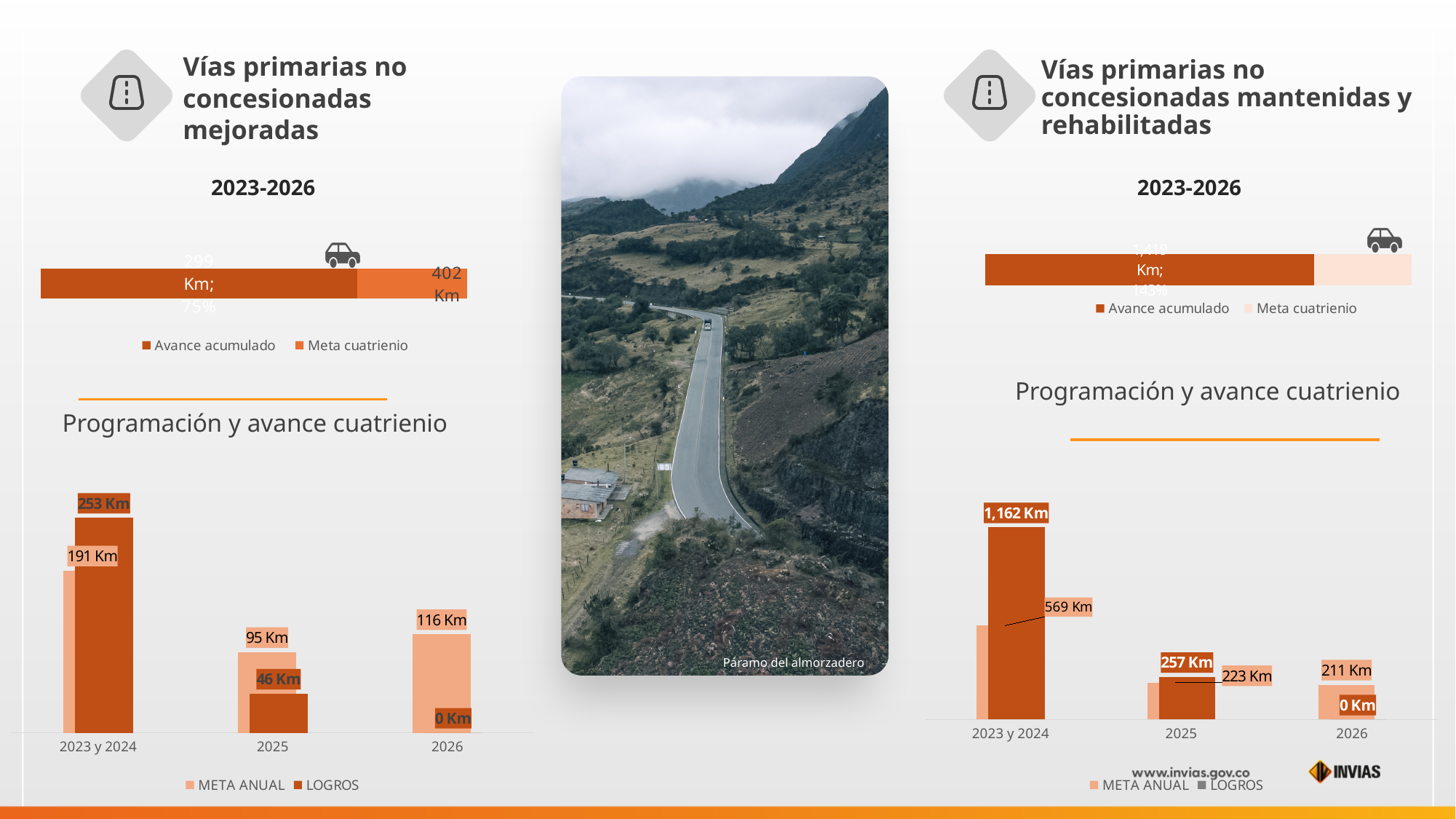
How many categories are shown on the x axis of the bottom-right bar chart? 3 In the bottom-right bar chart, what is the META ANUAL value for 2025? 223 Km In the bottom-right bar chart, what is the difference between LOGROS and META ANUAL for 2023 y 2024? 593 Km In the bottom-left bar chart, which category has the highest LOGROS value? 2023 y 2024 How many series does the legend of the top-left horizontal bar chart list? 2 In the bottom-right bar chart (Programación y avance cuatrienio, under Vías primarias no concesionadas mantenidas y rehabilitadas), what is the LOGROS value for 2023 y 2024? 1,162 Km In the bottom-left bar chart, what is the difference between META ANUAL and LOGROS for 2025? 49 Km In the top-left horizontal bar chart (Vías primarias no concesionadas mejoradas, 2023-2026), what is the Meta cuatrienio value? 402 Km In the bottom-left bar chart, what is the META ANUAL value for 2025? 95 Km In the bottom-left bar chart (Programación y avance cuatrienio, under Vías primarias no concesionadas mejoradas), what is the LOGROS value for 2023 y 2024? 253 Km In the bottom-right bar chart, which is larger for 2025, META ANUAL or LOGROS? LOGROS In the bottom-left bar chart, what is the LOGROS value for 2026? 0 Km